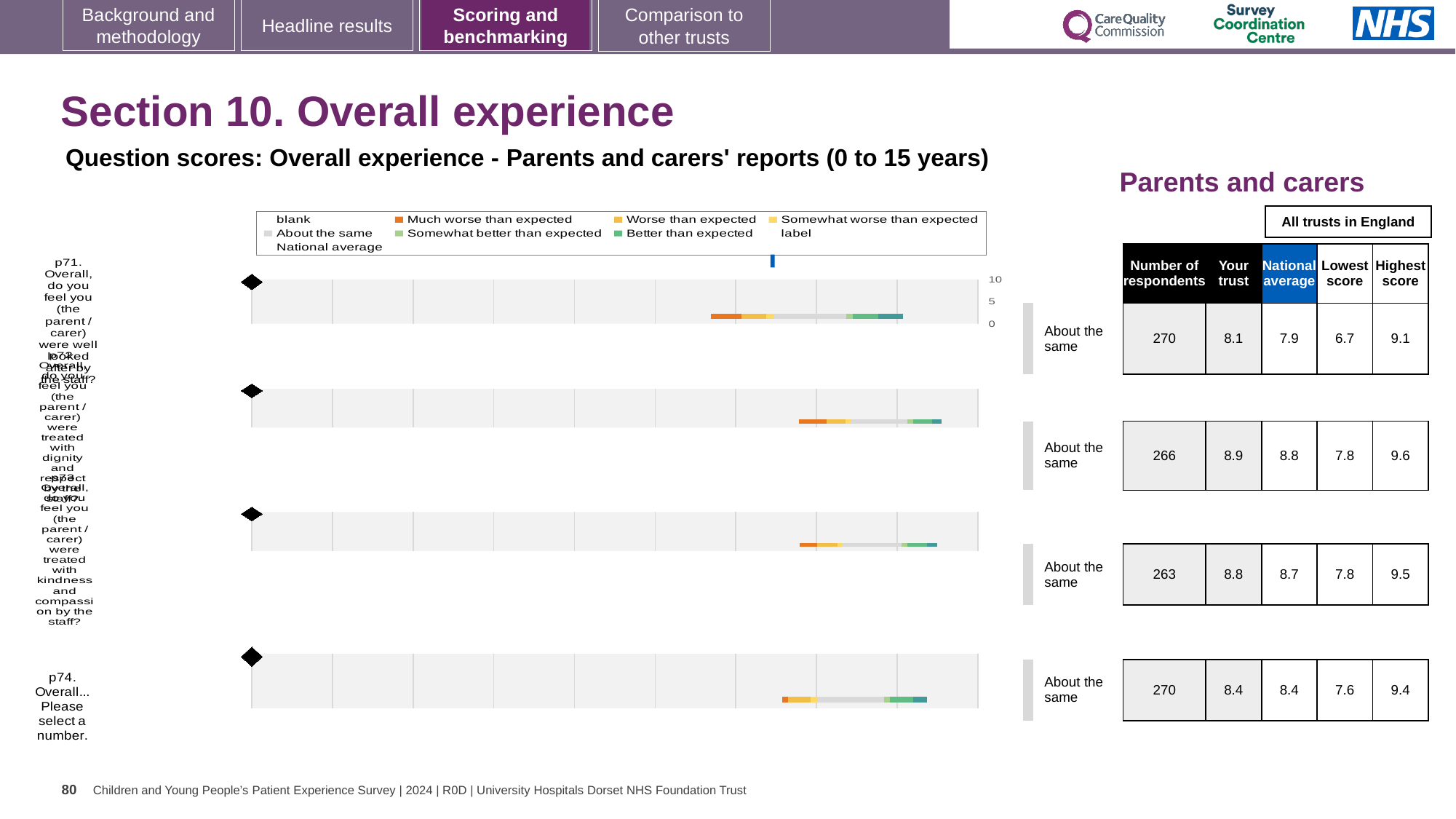
Which row of the chart has the highest 'Your trust' score? the second row (8.9) How many respondents are listed for question p74 (the bottom row)? 270 How many questions (rows) are plotted in the chart? 4 What is the difference between the 'Your trust' score and the national average for the first (top) row? 0.2 What kind of chart is used to show the question scores on this slide? bar chart What is the highest score across all trusts in England for question p74 (the bottom row)? 9.4 For the first (top) row, which is larger: the 'Your trust' score or the national average? Your trust What is the 'Your trust' score for question p74 (the bottom row)? 8.4 What is the 'Your trust' score for the first (top) row of the chart? 8.1 What is the national average for question p74 (the bottom row)? 8.4 What benchmark category is shown for all four questions in the chart? About the same Which row of the chart has the lowest 'Your trust' score? the first row (8.1)